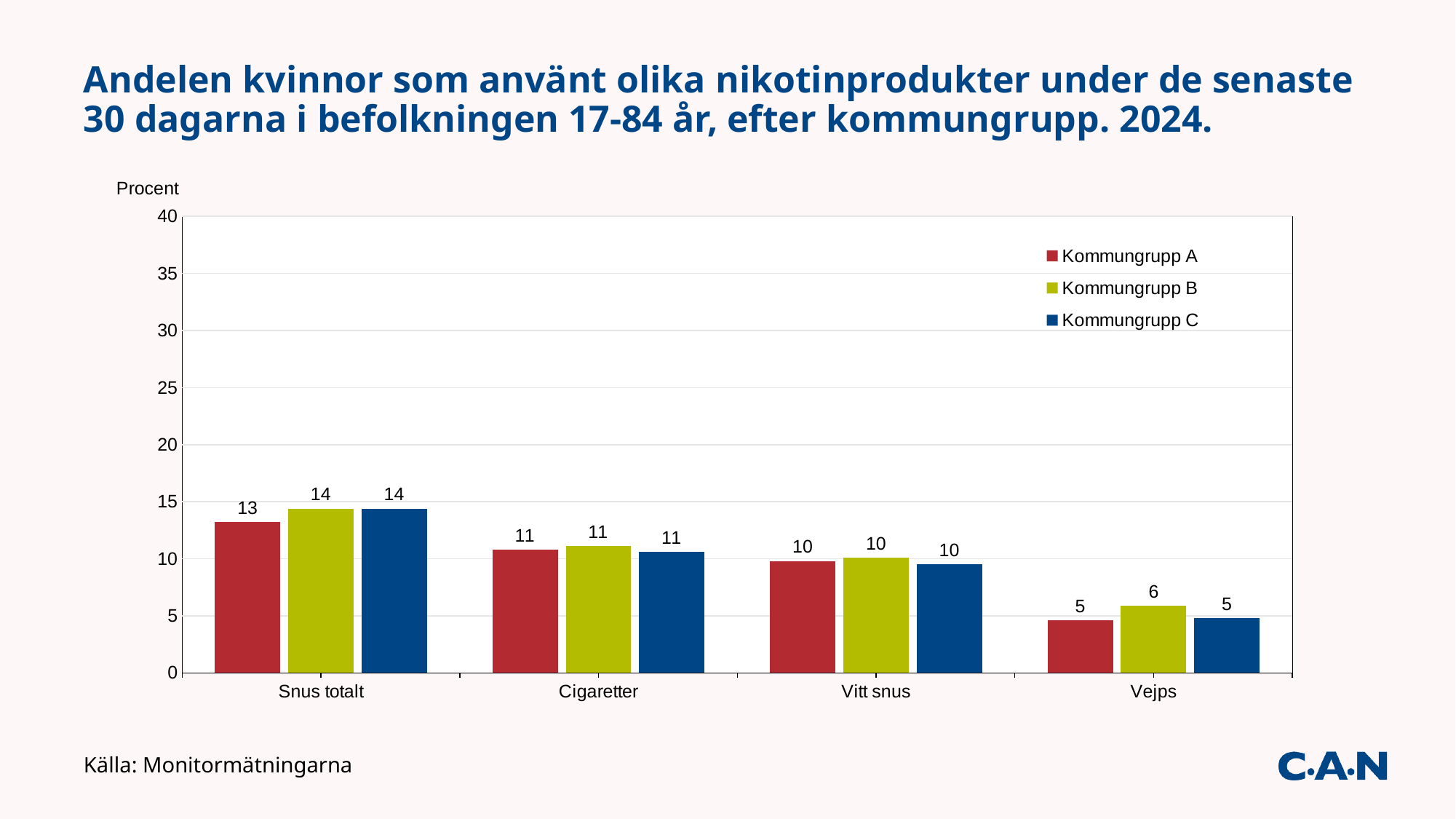
What kind of chart is shown on the slide? bar chart How many series does the legend list? 3 Is the value for Kommungrupp C in Snus totalt greater or less than 20? less In the Snus totalt category, which is larger: Kommungrupp A or Kommungrupp B? Kommungrupp B Which category has the lowest values across all three Kommungrupp series? Vejps What is the value for Kommungrupp C in the Cigaretter category? 11 How many product categories are shown on the x axis? 4 Which category has the highest values across all three Kommungrupp series? Snus totalt What is the value for Kommungrupp A in the Snus totalt category? 13 What is the difference between the Kommungrupp A values for Snus totalt and Vejps? 8 What is the value for Kommungrupp B in the Vejps category? 6 What is the difference between the Kommungrupp B values for Snus totalt and Cigaretter? 3